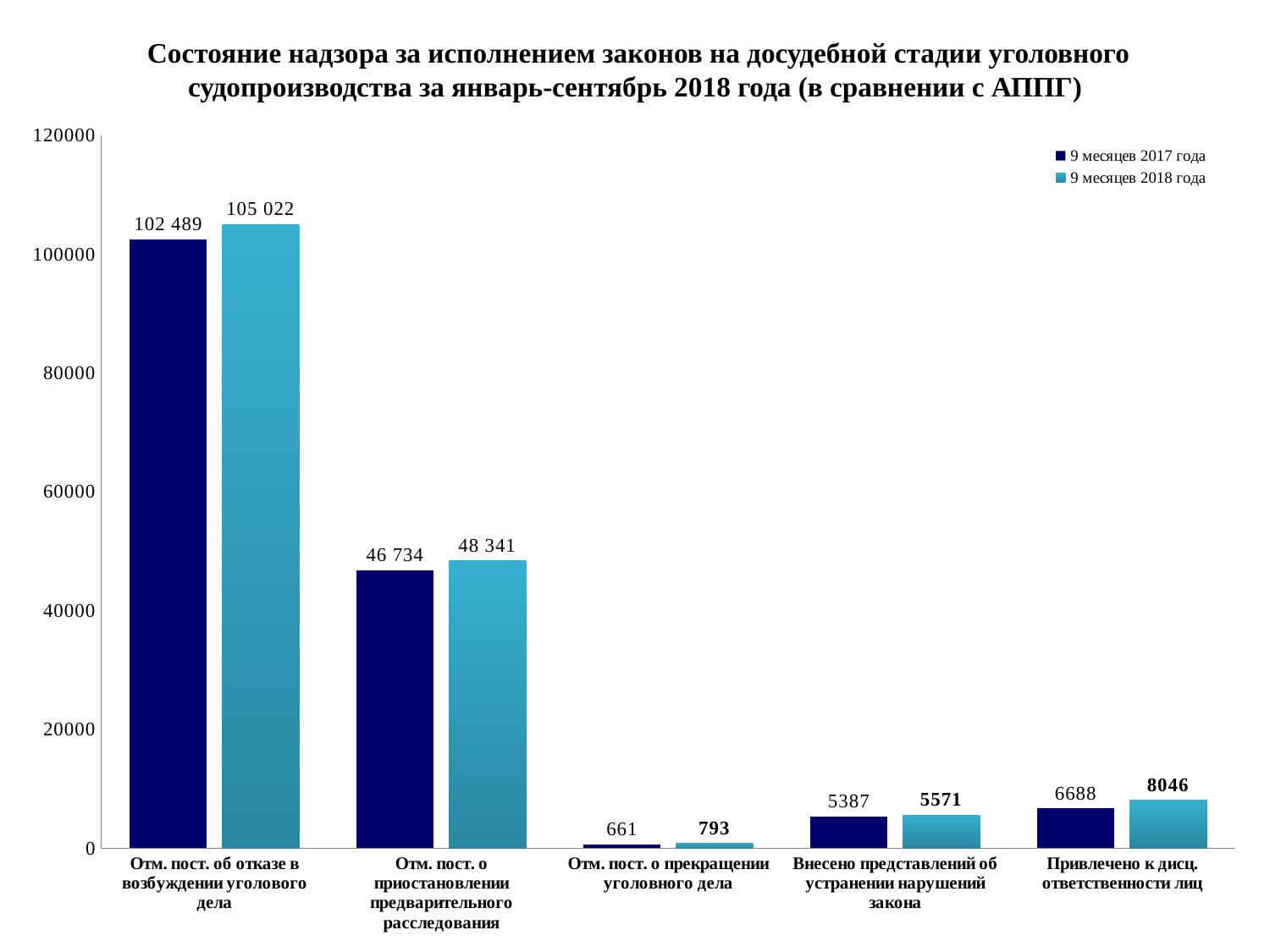
What is the value for "Отм. пост. о прекращении уголовного дела" in the "9 месяцев 2017 года" series? 661 What is the difference between the 2018 and 2017 values for "Внесено представлений об устранении нарушений закона"? 184 Which category has the highest value in the "9 месяцев 2018 года" series? Отм. пост. об отказе в возбуждении уголового дела What kind of chart is shown on the slide? Bar chart Which is larger for "Отм. пост. о приостановлении предварительного расследования": the 2017 value or the 2018 value? 9 месяцев 2018 года How many categories are shown on the x axis? 5 What is the difference between the 2018 and 2017 values for "Привлечено к дисц. ответственности лиц"? 1358 What is the value for "Привлечено к дисц. ответственности лиц" in the "9 месяцев 2018 года" series? 8046 What is the value for "Отм. пост. о приостановлении предварительного расследования" in the "9 месяцев 2017 года" series? 46 734 How many series does the legend list? 2 Which category has the lowest value in the "9 месяцев 2017 года" series? Отм. пост. о прекращении уголовного дела What is the value for "Отм. пост. об отказе в возбуждении уголового дела" in the "9 месяцев 2018 года" series? 105 022